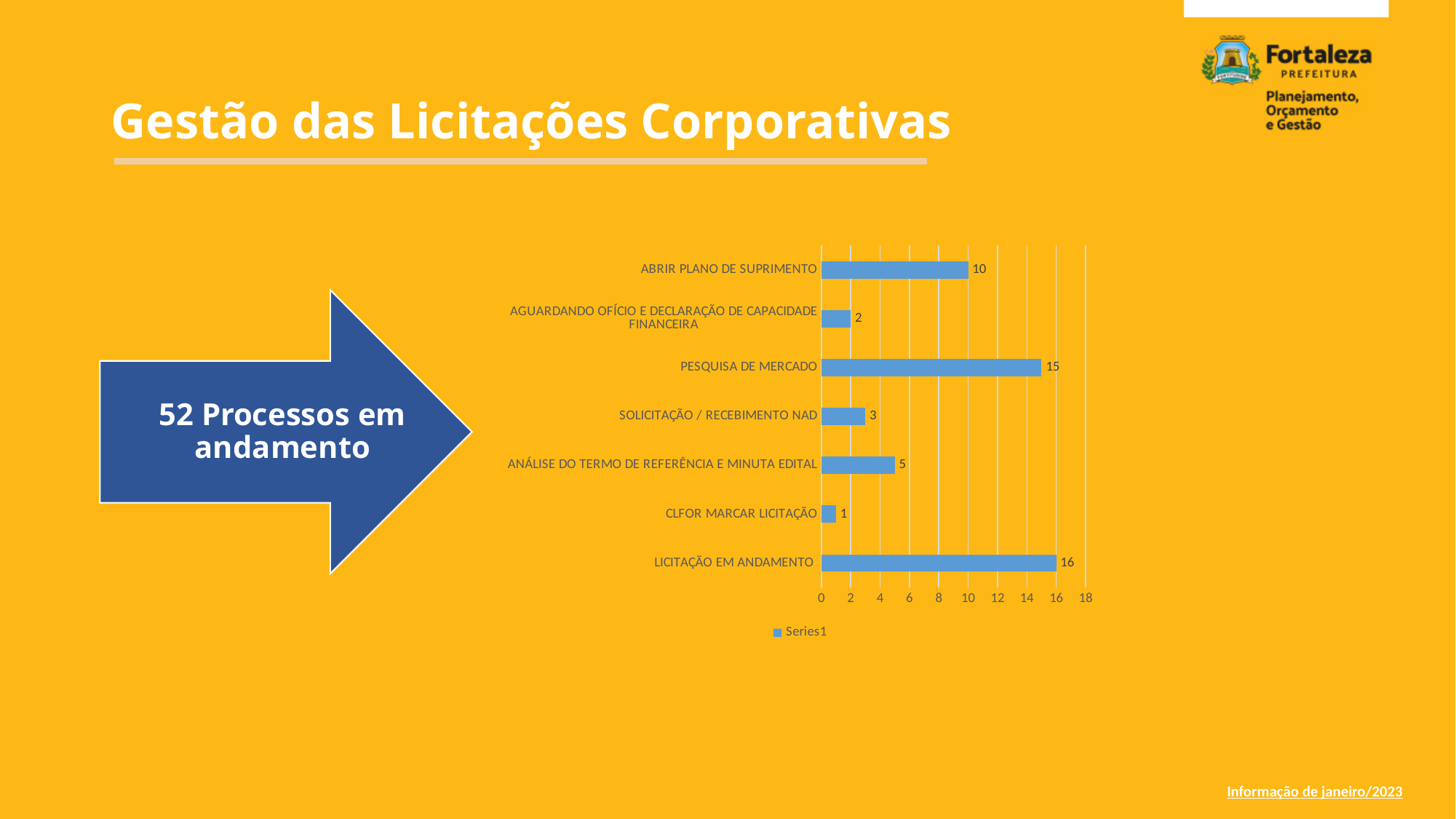
How many series does the legend list? 1 What is the value for ABRIR PLANO DE SUPRIMENTO? 10 Which is larger, SOLICITAÇÃO / RECEBIMENTO NAD or AGUARDANDO OFÍCIO E DECLARAÇÃO DE CAPACIDADE FINANCEIRA? SOLICITAÇÃO / RECEBIMENTO NAD What is the value for CLFOR MARCAR LICITAÇÃO? 1 Which category has the highest value? LICITAÇÃO EM ANDAMENTO What is the legend entry shown below the chart? Series1 Which category has the lowest value? CLFOR MARCAR LICITAÇÃO What is the difference between ABRIR PLANO DE SUPRIMENTO and ANÁLISE DO TERMO DE REFERÊNCIA E MINUTA EDITAL? 5 What kind of chart is shown on the slide? Bar chart How many categories does the chart show? 7 What is the value for PESQUISA DE MERCADO? 15 What is the difference between LICITAÇÃO EM ANDAMENTO and PESQUISA DE MERCADO? 1